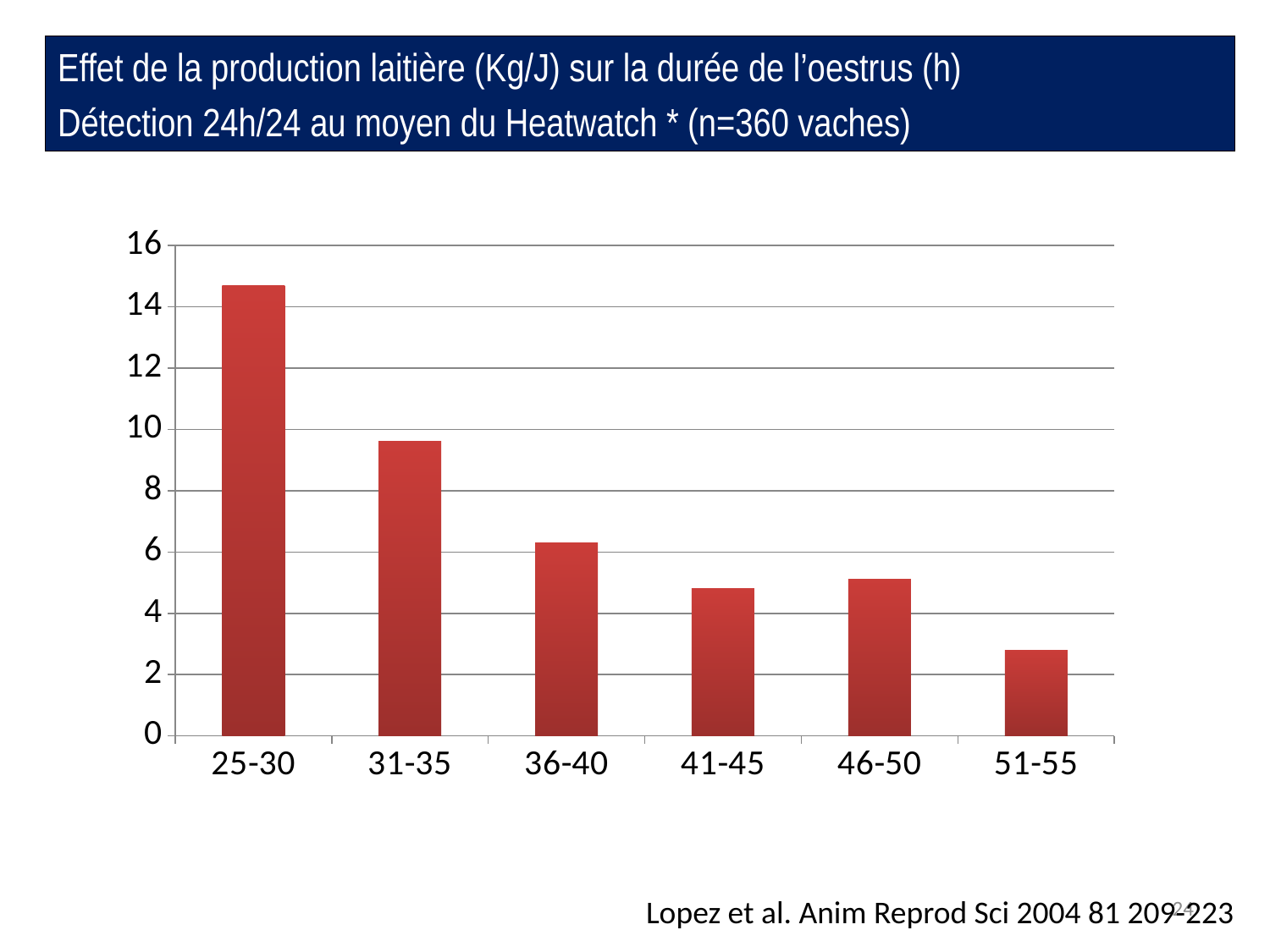
Which is larger, the value for 31-35 or the value for 36-40? 31-35 Is the value for 31-35 greater or less than 8? greater Do the values generally rise or fall from the 25-30 category to the 51-55 category? fall Is the value for 51-55 greater or less than 4? less How many milk production categories are shown on the x axis? 6 Which milk production category has the highest bar? 25-30 Which milk production category has the lowest bar? 51-55 Is the value for 41-45 greater or less than 6? less What kind of chart is shown on the slide? bar chart What is the maximum value shown on the vertical axis? 16